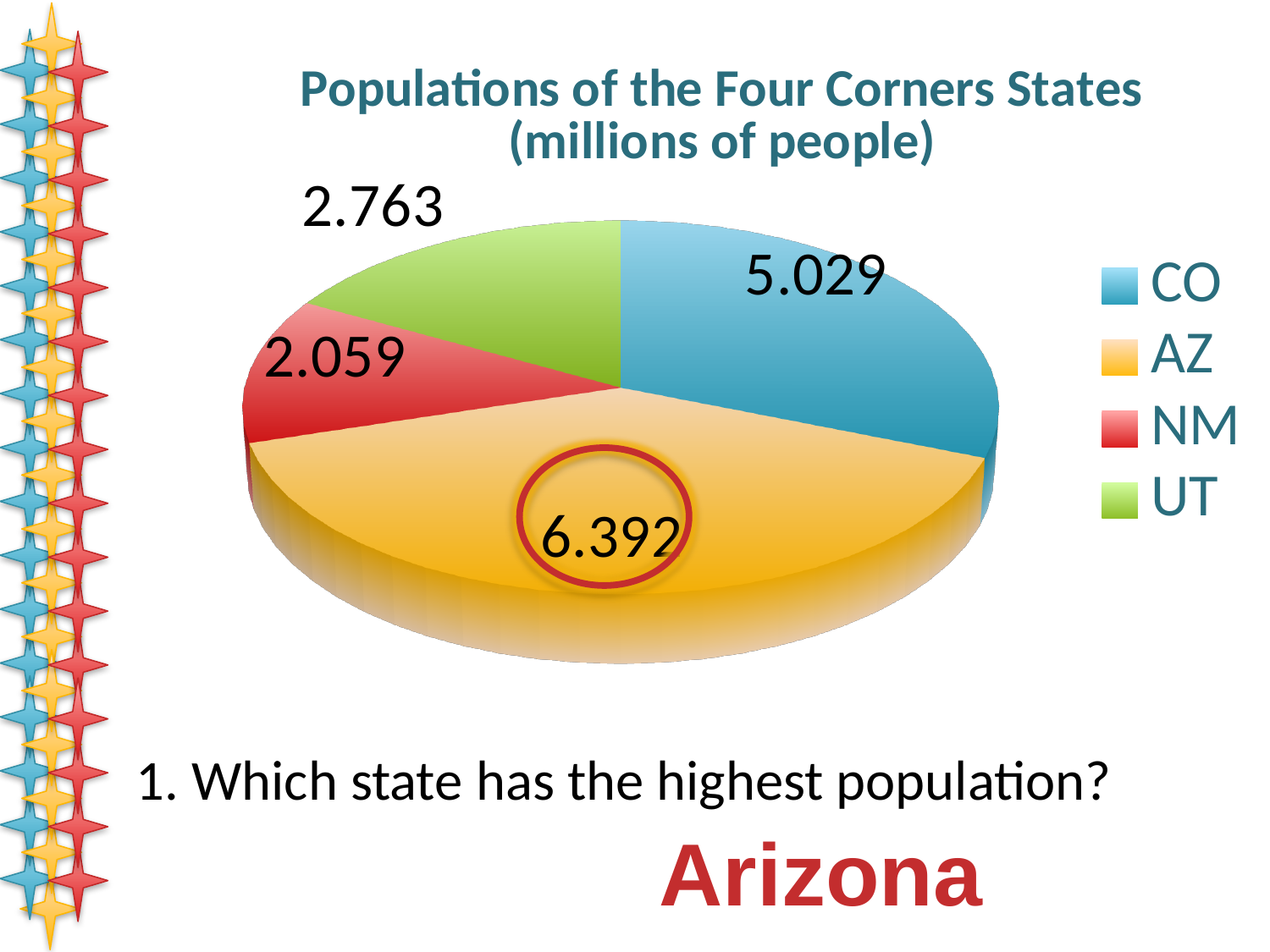
What is the difference between the values for AZ and CO? 1.363 What is the title of the chart? Populations of the Four Corners States (millions of people) What is the population value shown for NM? 2.059 What is the population value shown for UT? 2.763 What is the population value shown for CO? 5.029 Which state has the smallest slice of the pie? NM Which colour represents CO in the legend? blue Which state has the largest slice of the pie? AZ What type of chart is shown on the slide? pie chart How many states are shown in the pie chart? 4 What is the population value shown for AZ? 6.392 Which has a larger value, UT or NM? UT